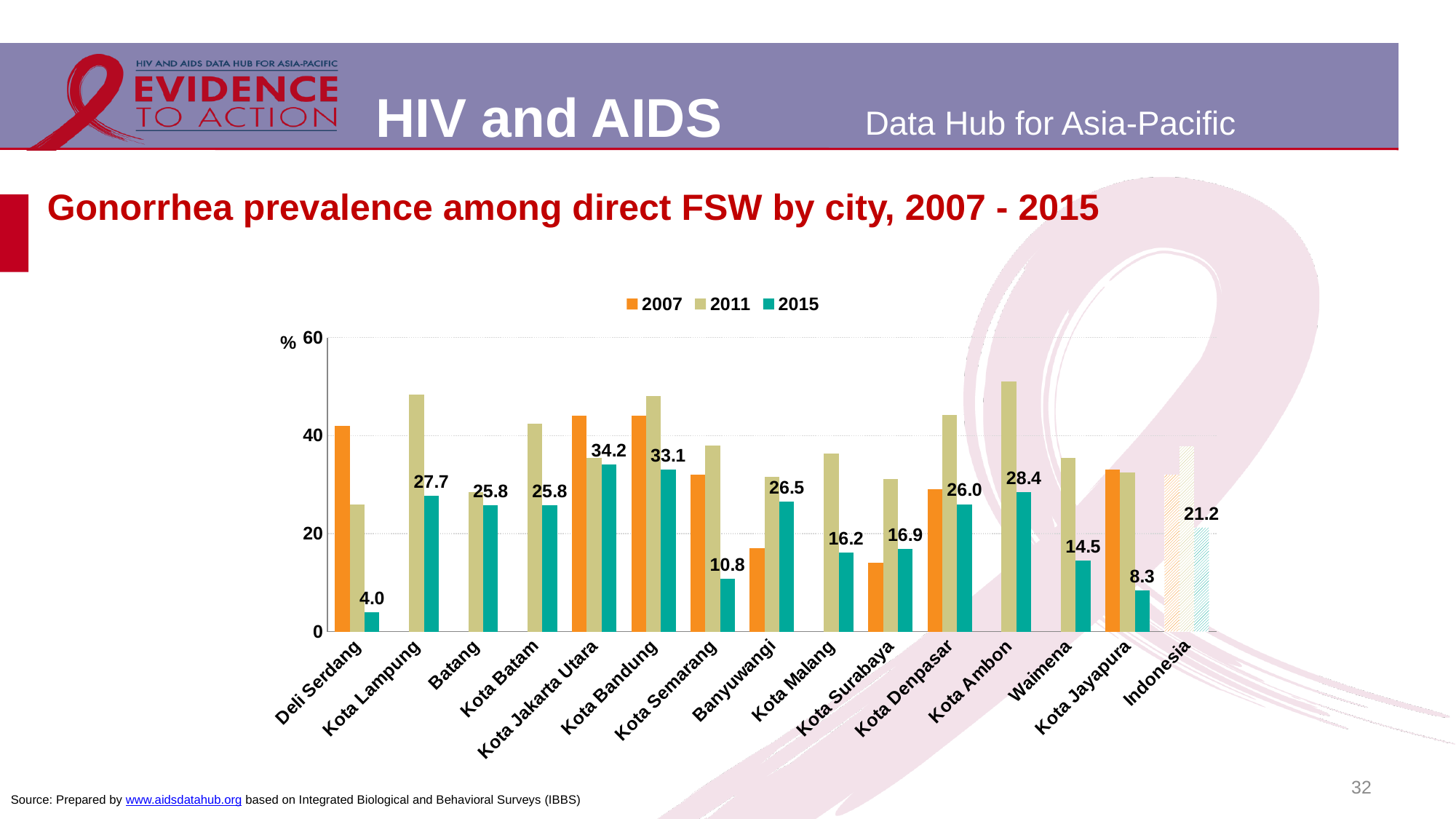
What is the 2015 value for Indonesia? 21.2 Which has the larger 2015 value, Kota Lampung or Batang? Kota Lampung Which city has the highest 2015 value? Kota Jakarta Utara What is the 2015 value for Deli Serdang? 4.0 Is the 2011 value for Kota Ambon greater or less than 40? greater Which city has the lowest 2015 value? Deli Serdang How many cities/categories are shown on the x axis? 15 What is the 2015 gonorrhea prevalence for Kota Jakarta Utara? 34.2 What is the difference between the 2015 values for Kota Ambon and Waimena? 13.9 What is the title of the chart? Gonorrhea prevalence among direct FSW by city, 2007 - 2015 What type of chart is shown on the slide? Bar chart How many series does the legend list? 3